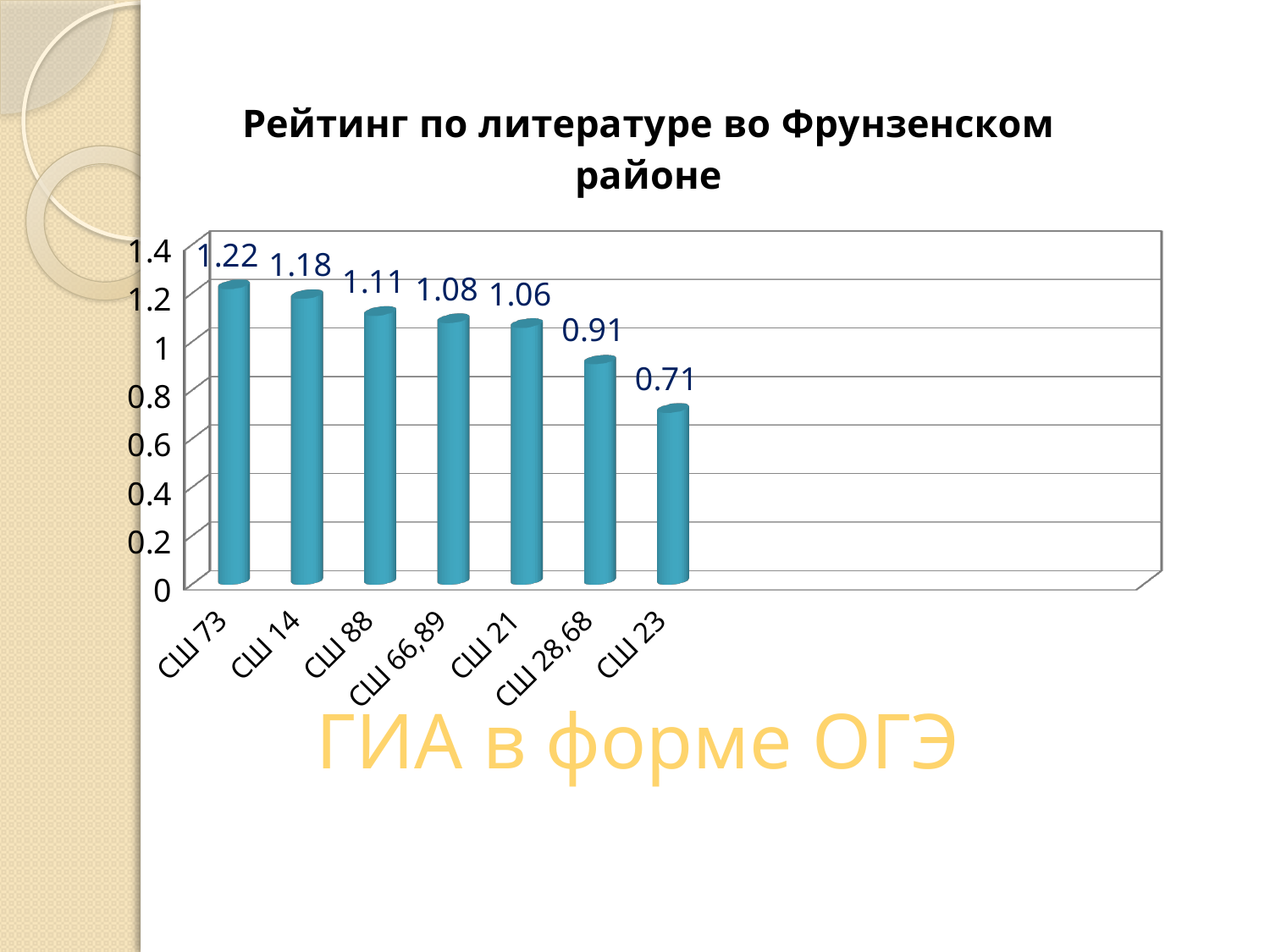
Which category has the highest value? СШ 73 What is the value for СШ 73? 1.22 Do the values rise or fall from left to right along the x axis? fall What is the difference between the values for СШ 73 and СШ 23? 0.51 Which category has the lowest value? СШ 23 What is the value for СШ 66,89? 1.08 Which is larger, the value for СШ 88 or the value for СШ 21? СШ 88 Is the value for СШ 28,68 greater or less than 1? less What kind of chart is shown on the slide? bar chart What is the difference between the values for СШ 14 and СШ 28,68? 0.27 What is the value for СШ 23? 0.71 How many categories are shown on the chart? 7